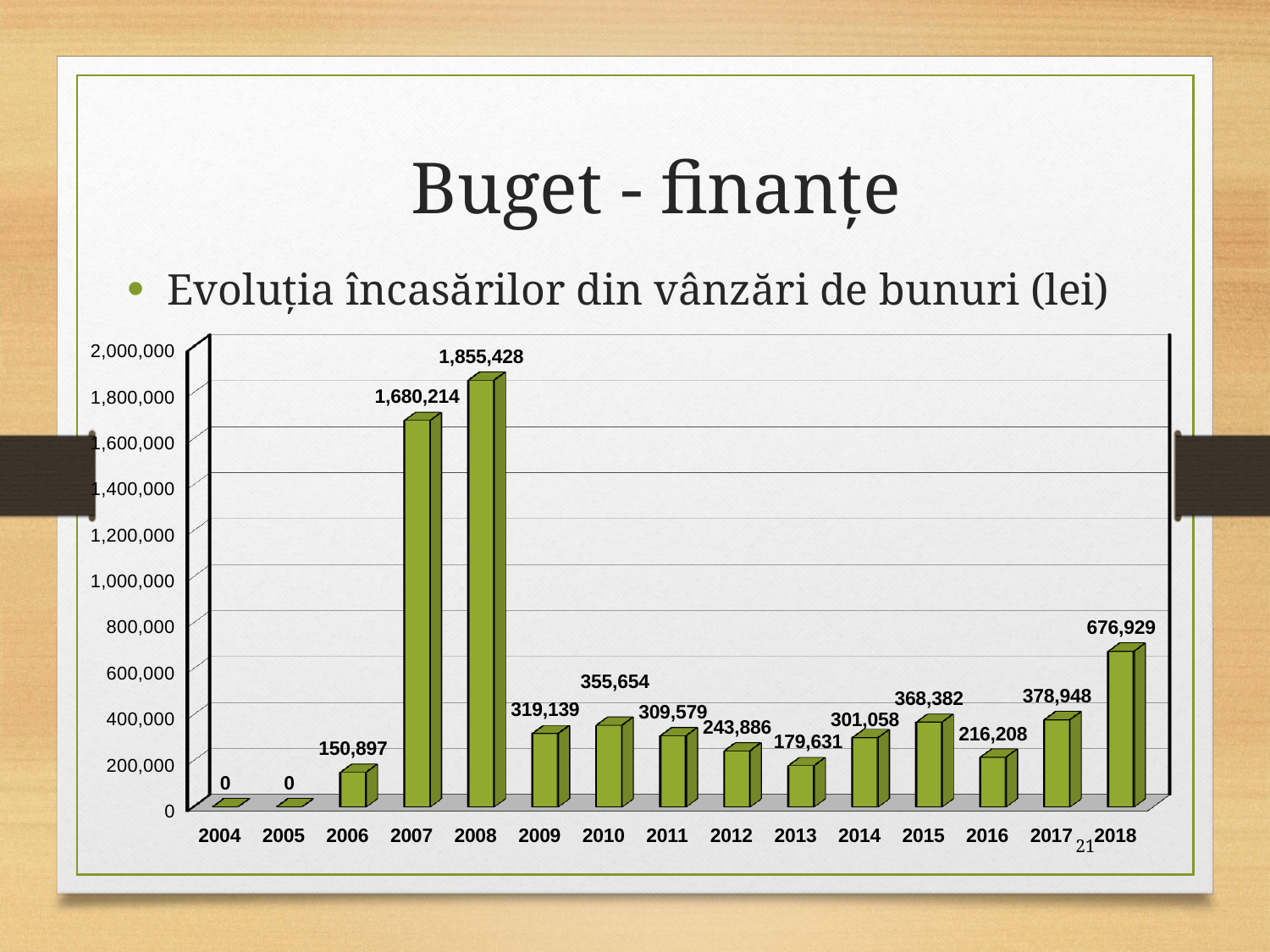
Is the value for 2018 greater or less than 600,000? greater What kind of chart is shown? bar chart What is the title of the slide? Buget - finanțe Which is larger, the value for 2010 or the value for 2011? 2010 Which year has the lowest non-zero value? 2006 Do the values rise or fall from 2016 to 2018? rise What is the value for 2018? 676,929 Which year has the highest value? 2008 What is the value for 2008? 1,855,428 What is the value for 2013? 179,631 How many years are shown on the x axis? 15 What is the difference between the values for 2008 and 2007? 175,214